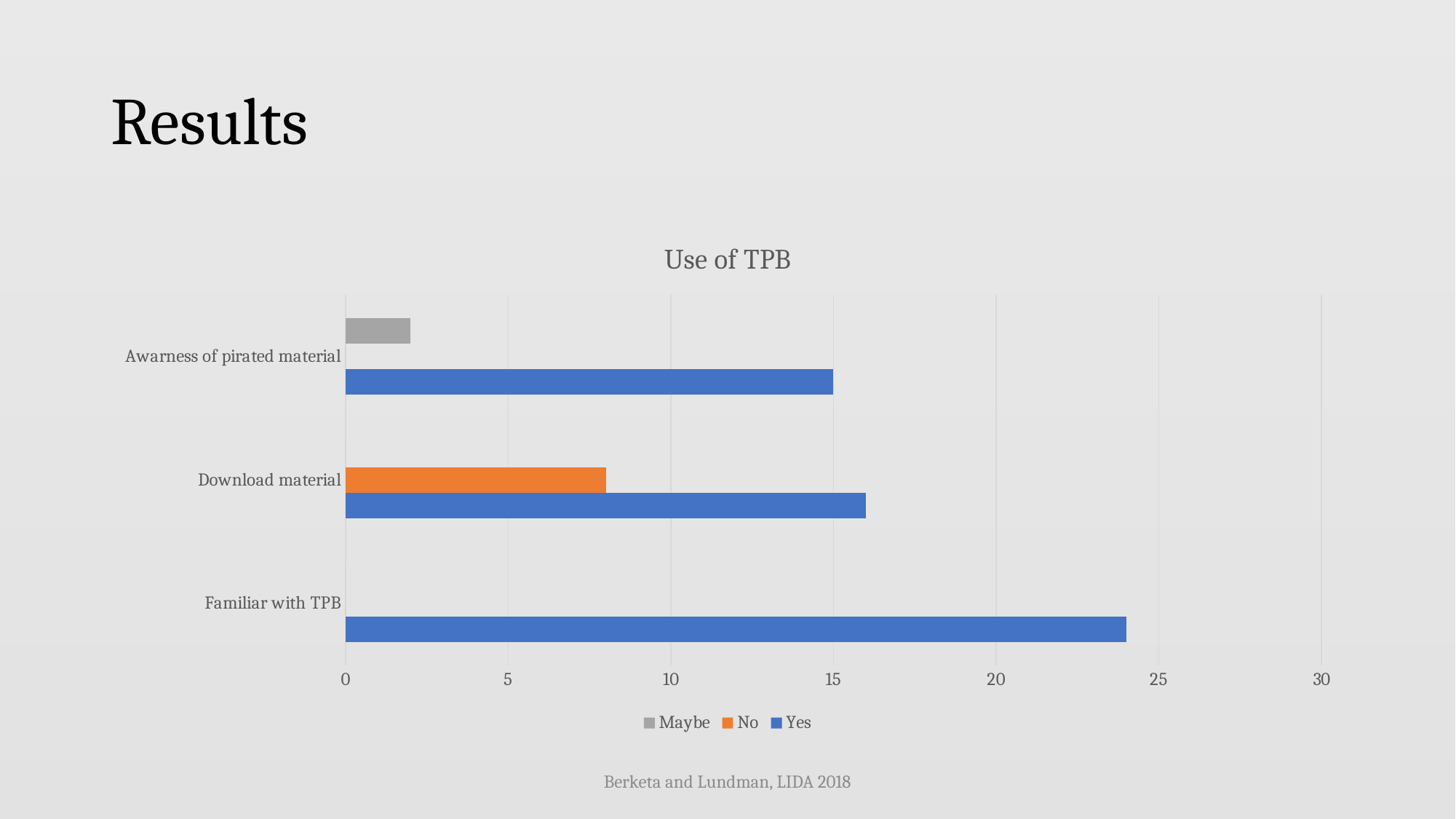
What kind of chart is shown on the slide? bar chart Which category has the highest 'Yes' value? Familiar with TPB Which category has the lowest 'Yes' value? Awarness of pirated material How many series does the legend list? 3 Which is larger for Download material: the 'Yes' value or the 'No' value? Yes Is the 'Yes' value for Download material greater or less than 10? greater Is the 'No' value for Download material greater or less than 10? less Which category shows a 'Maybe' bar? Awarness of pirated material Is the 'Yes' value for Familiar with TPB greater or less than 20? greater How many categories are shown on the vertical axis of the chart? 3 What is the title of the chart? Use of TPB